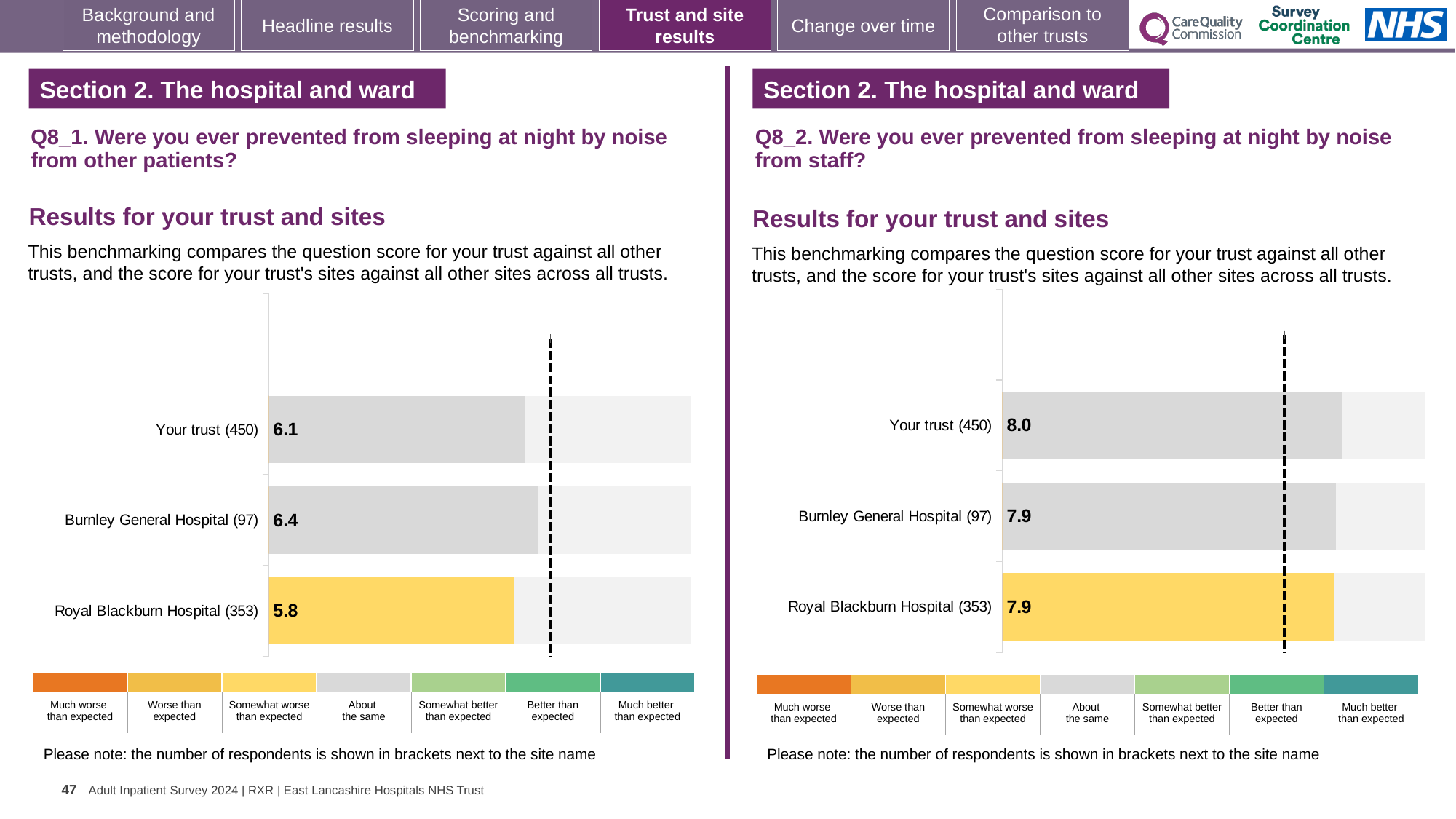
On the Q8_2 chart (right), what is the score for Your trust (450)? 8.0 On the Q8_2 chart (right), what is the difference between the scores for Your trust (450) and Burnley General Hospital (97)? 0.1 On the Q8_2 chart (right), what is the score for Burnley General Hospital (97)? 7.9 On the Q8_1 chart (left), which benchmark category does the colour of the Royal Blackburn Hospital (353) bar indicate? Somewhat worse than expected On the Q8_1 chart (left), what is the difference between the scores for Burnley General Hospital (97) and Royal Blackburn Hospital (353)? 0.6 What type of chart is used on the Q8_2 chart (right)? Bar chart On the Q8_1 chart (left), what is the score for Your trust (450)? 6.1 How many bars are plotted on the Q8_1 chart (left)? 3 On the Q8_1 chart (left), which site or trust has the lowest score? Royal Blackburn Hospital (353) On the Q8_1 chart (left), which site or trust has the highest score? Burnley General Hospital (97) On the Q8_2 chart (right), which has the higher score, Your trust (450) or Royal Blackburn Hospital (353)? Your trust (450) On the Q8_1 chart (left), what is the score for Royal Blackburn Hospital (353)? 5.8